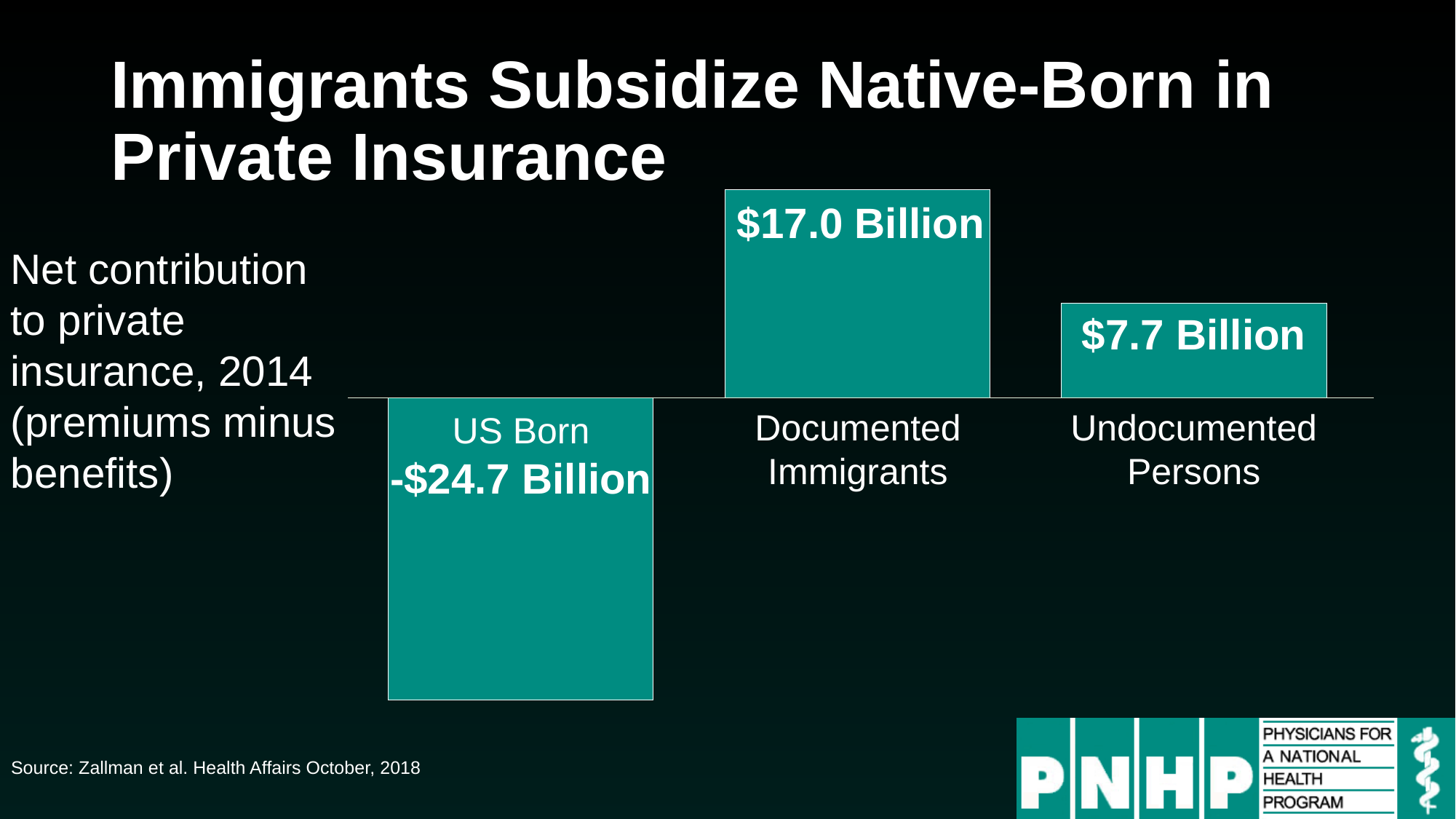
What is the net contribution to private insurance for US Born? -$24.7 Billion Which category has the lowest net contribution to private insurance? US Born What year does the chart's net contribution data refer to? 2014 Which category has the highest net contribution to private insurance? Documented Immigrants Which category is the only one with a negative net contribution? US Born What is the net contribution to private insurance for Documented Immigrants? $17.0 Billion What is the net contribution to private insurance for Undocumented Persons? $7.7 Billion Which is larger, the net contribution of Documented Immigrants or of Undocumented Persons? Documented Immigrants What kind of chart is shown on the slide? Bar chart How many categories are shown in the chart? 3 What is the difference between the net contributions of Documented Immigrants and Undocumented Persons? $9.3 Billion